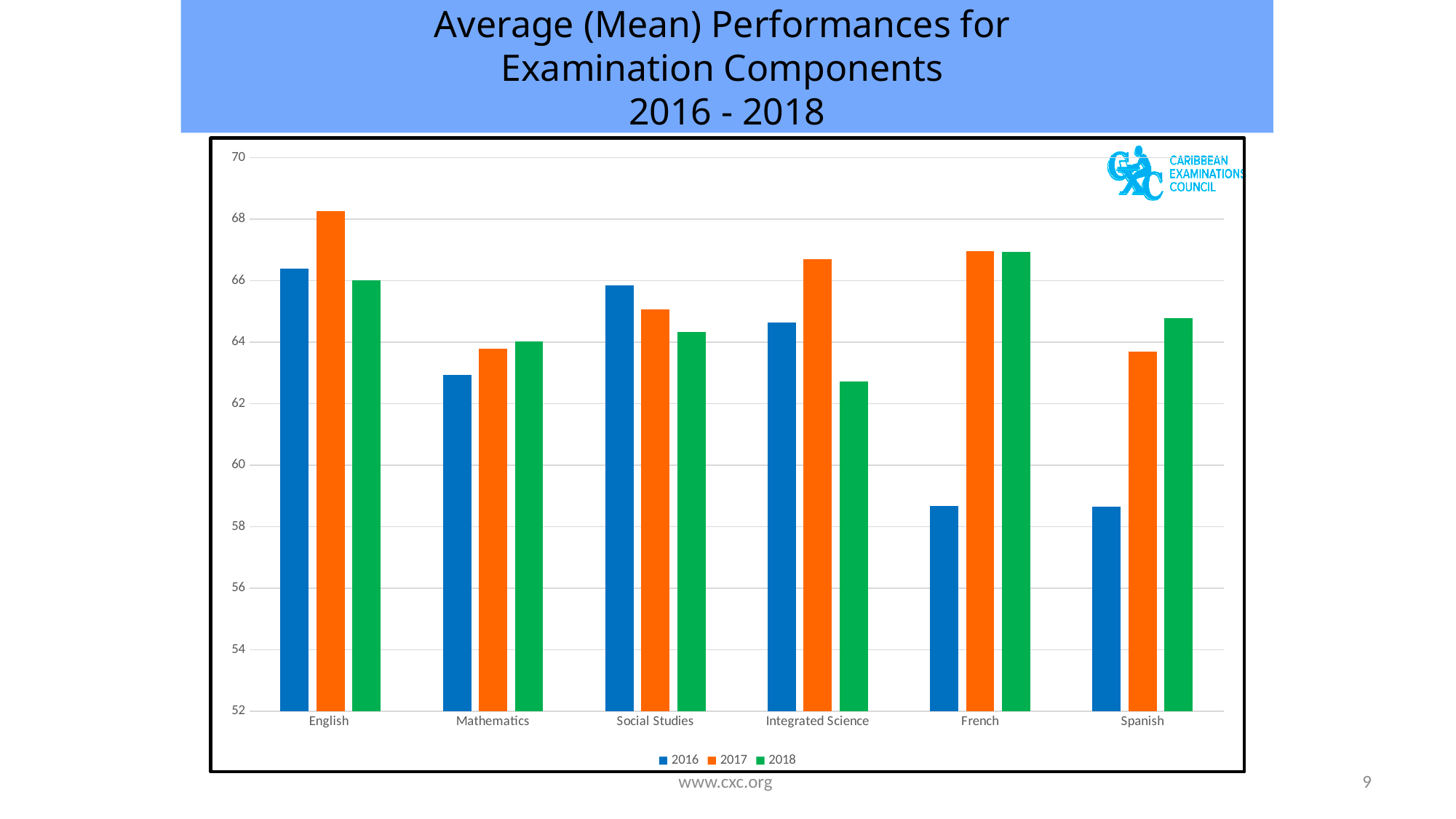
How many examination components (categories) are shown on the x axis? 6 Is the 2016 value for French greater or less than 60? less Is the 2016 value for Mathematics greater or less than 64? less Do the values for Social Studies rise or fall from 2016 to 2018? fall Which examination component has the highest value for 2017? English Which examination component has the lowest value for 2018? Integrated Science For Integrated Science, which year has the larger value, 2016 or 2017? 2017 Is the 2017 value for English greater or less than 68? greater How many series does the legend list? 3 What kind of chart is shown on the slide? Bar chart For Social Studies, which year has the larger value, 2016 or 2018? 2016 Which colour represents the 2018 series in the legend? Green